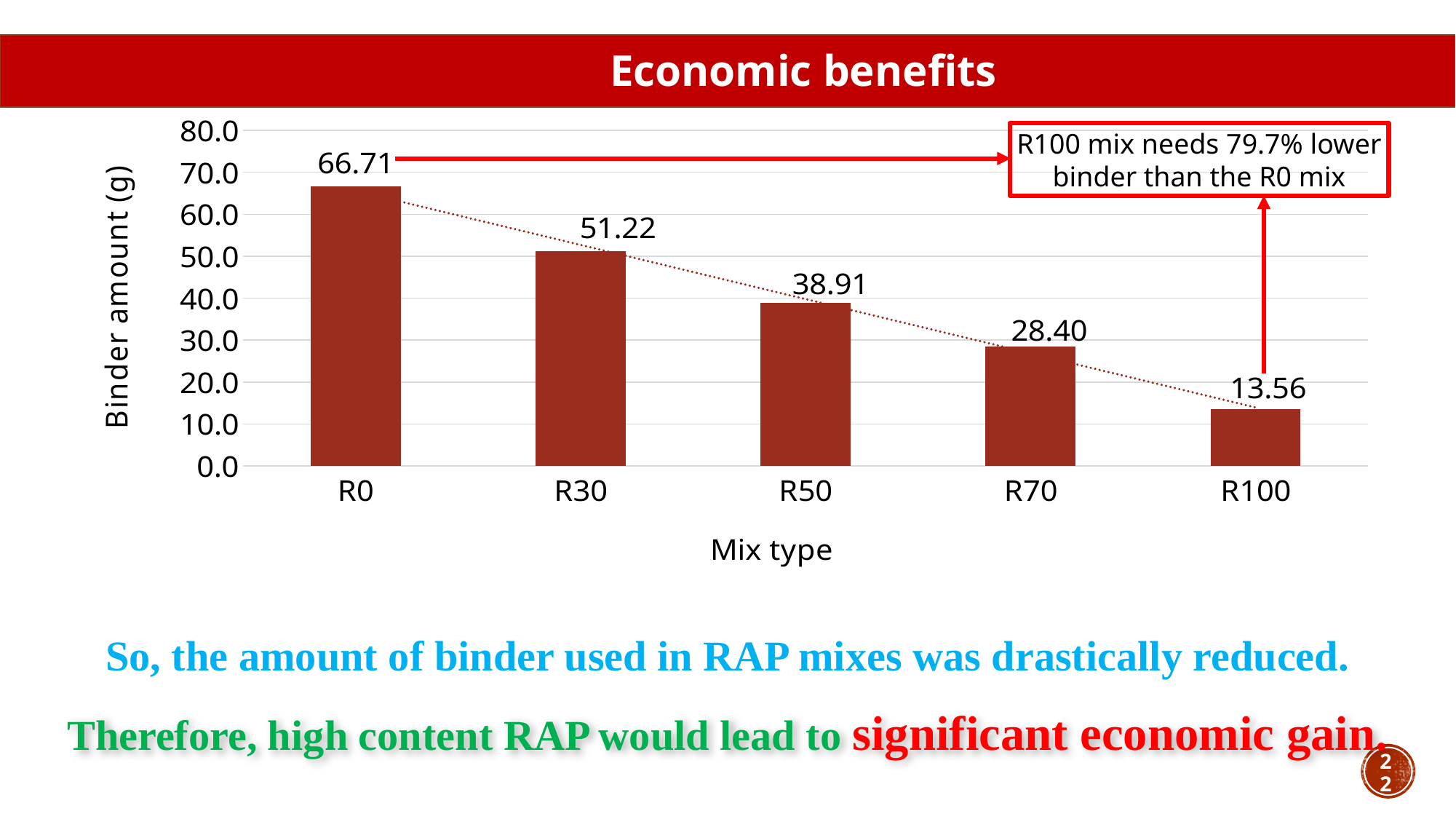
What is the binder amount for the R100 mix? 13.56 What is the difference in binder amount between the R0 and R100 mixes? 53.15 Is the binder amount for R70 greater or less than 30.0? less Do the binder amounts rise or fall from R0 to R100 along the x axis? Fall How many mix types are shown on the x axis? 5 What is the binder amount for the R0 mix? 66.71 Which mix type has the lowest binder amount? R100 What kind of chart is shown on the slide? Bar chart Which mix type has the highest binder amount? R0 Which has a larger binder amount, R70 or R30? R30 What is the difference in binder amount between the R30 and R50 mixes? 12.31 What is the binder amount for the R50 mix? 38.91